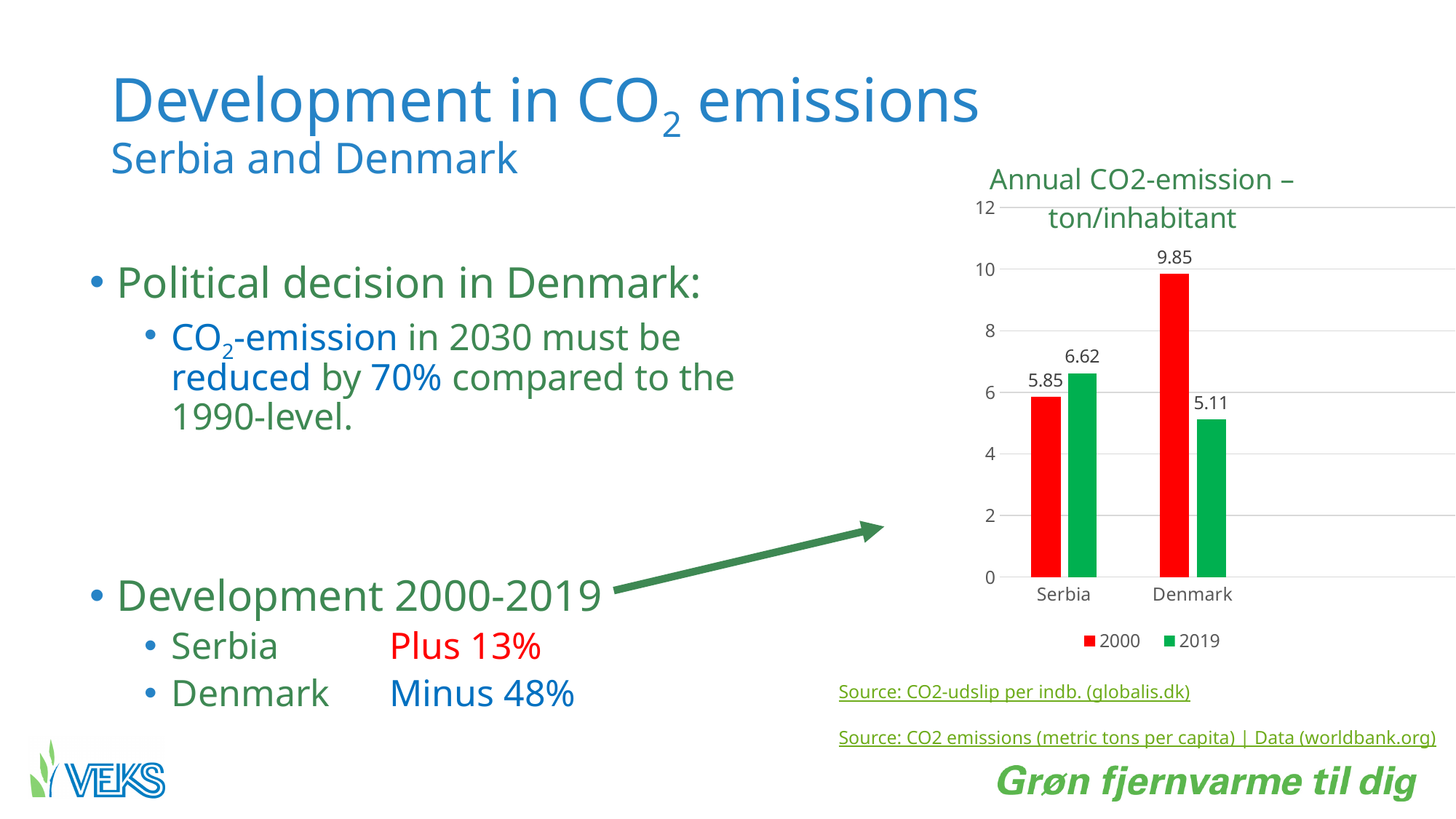
What is the annual CO2 emission for Denmark in 2019? 5.11 Which country has the highest value in the 2000 series? Denmark What is the annual CO2 emission for Serbia in 2000? 5.85 How many countries are shown on the x axis of the chart? 2 Which is larger for Serbia: the 2000 value or the 2019 value? 2019 How many series does the legend list? 2 What is the difference between Denmark's 2000 and 2019 values? 4.74 What is the title of the chart? Annual CO2-emission – ton/inhabitant Which bar shows the lowest value on the chart? Denmark 2019 What is the annual CO2 emission for Serbia in 2019? 6.62 What kind of chart is shown on the slide? Bar chart Is the value for Denmark in 2000 greater or less than 8? greater